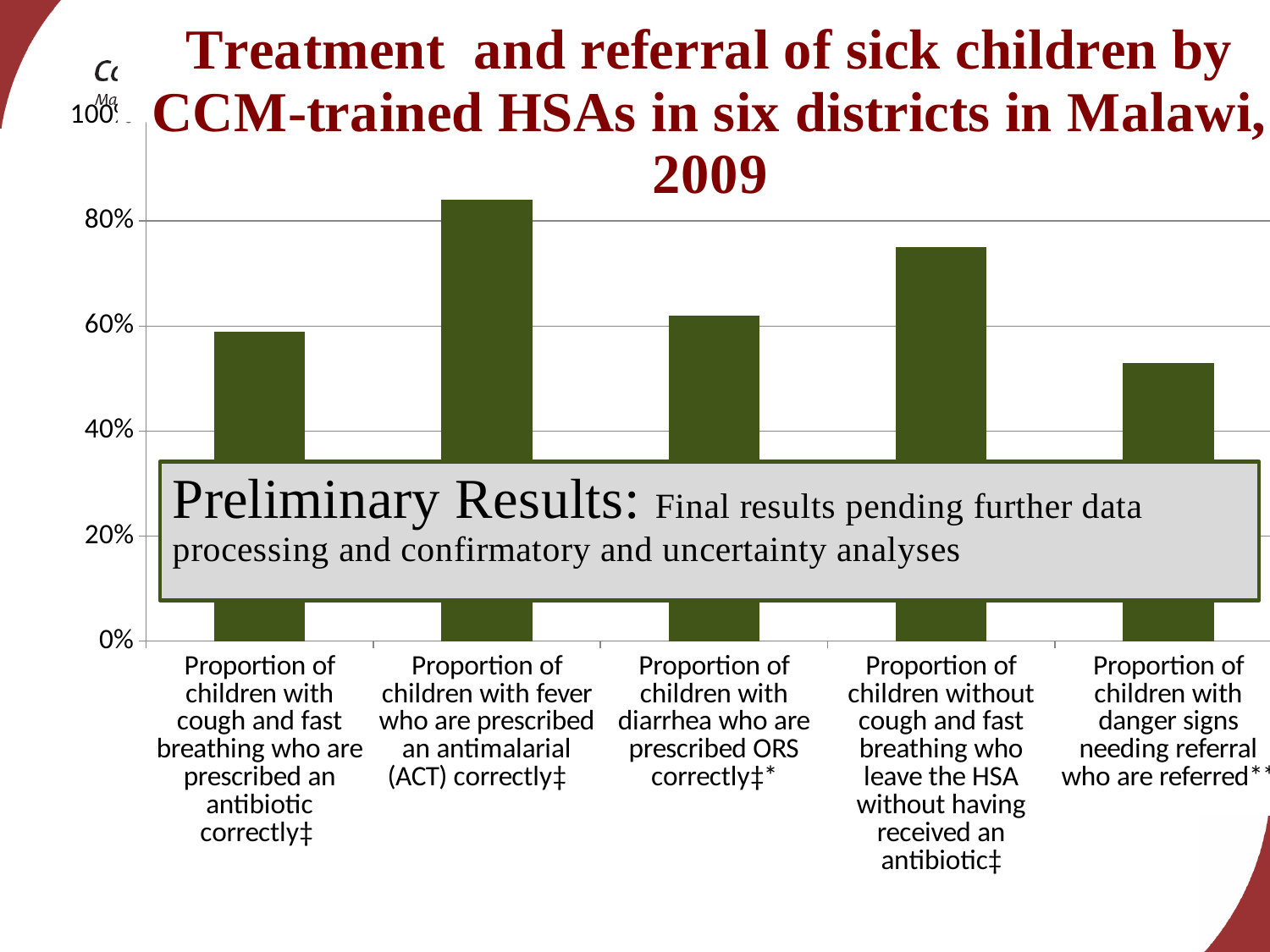
What kind of chart is shown on the slide? bar chart How many bars (categories) does the chart show? 5 Is the value for the proportion of children without cough and fast breathing who leave the HSA without having received an antibiotic greater or less than 80%? less Which category has the lowest bar? Proportion of children with danger signs needing referral who are referred Is the value for the proportion of children with fever who are prescribed an antimalarial (ACT) correctly greater or less than 80%? greater Which category has the highest bar? Proportion of children with fever who are prescribed an antimalarial (ACT) correctly What colour are the bars in the chart? dark green Which is larger: the proportion of children with fever prescribed an antimalarial (ACT) correctly, or the proportion of children with diarrhea prescribed ORS correctly? Proportion of children with fever who are prescribed an antimalarial (ACT) correctly Is the value for the proportion of children with cough and fast breathing who are prescribed an antibiotic correctly greater or less than 40%? greater Which is larger: the proportion of children without cough and fast breathing who leave the HSA without an antibiotic, or the proportion of children with danger signs needing referral who are referred? Proportion of children without cough and fast breathing who leave the HSA without having received an antibiotic